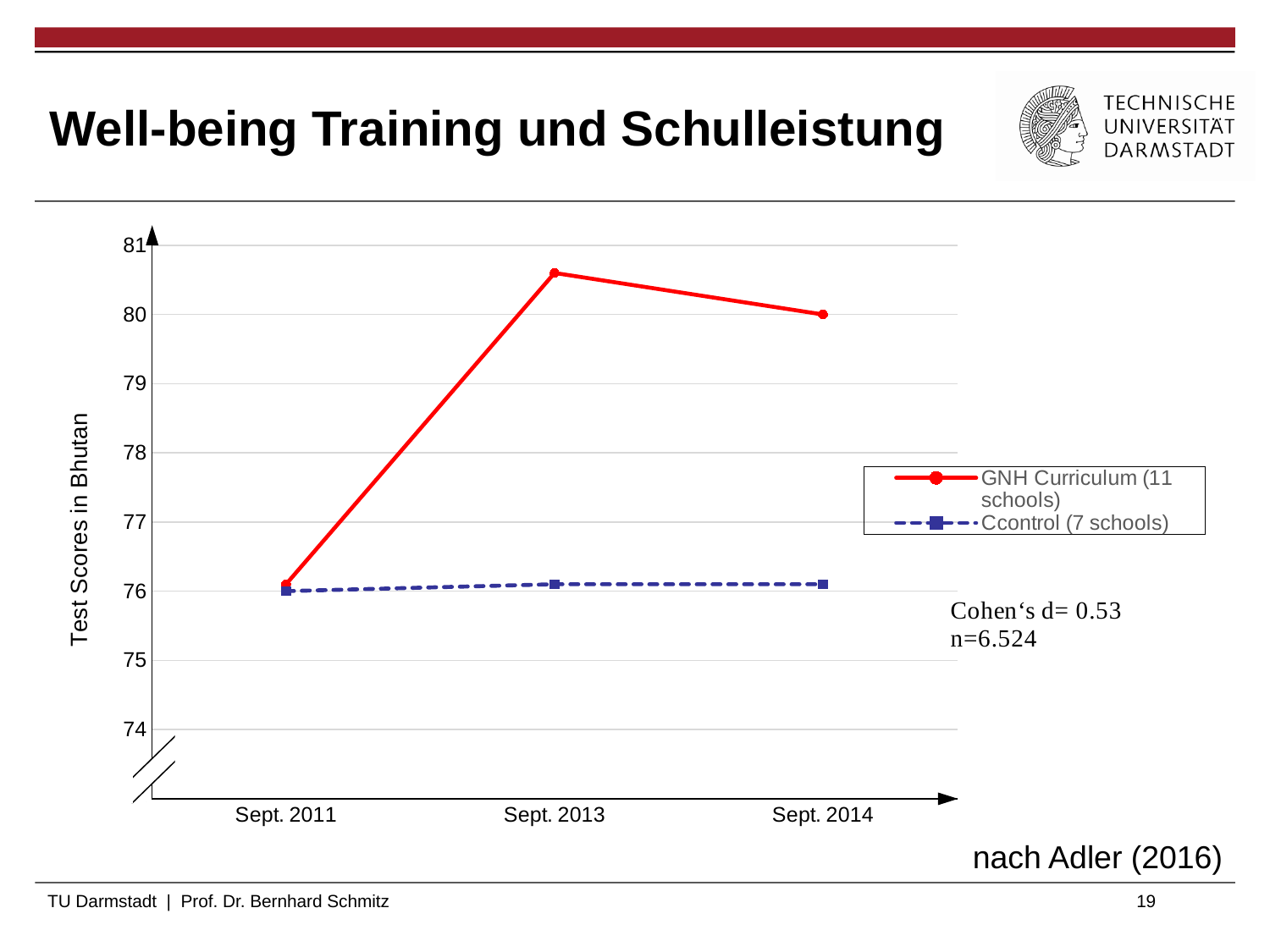
At which time point is the GNH Curriculum (11 schools) series lowest? Sept. 2011 Which series is drawn with a dashed line? Ccontrol (7 schools) At which time point does the GNH Curriculum (11 schools) series reach its highest value? Sept. 2013 What is the label of the y axis? Test Scores in Bhutan How many series does the legend list? 2 Is the value for Ccontrol (7 schools) at Sept. 2014 greater or less than 77? less At Sept. 2013, which series has the higher value: GNH Curriculum (11 schools) or Ccontrol (7 schools)? GNH Curriculum (11 schools) What is the value of the GNH Curriculum (11 schools) series at Sept. 2014? 80 Is the value for GNH Curriculum (11 schools) at Sept. 2011 greater or less than 77? less What kind of chart is shown on the slide? line chart Is the value for GNH Curriculum (11 schools) at Sept. 2013 greater or less than 80? greater How many time points are plotted along the x axis? 3